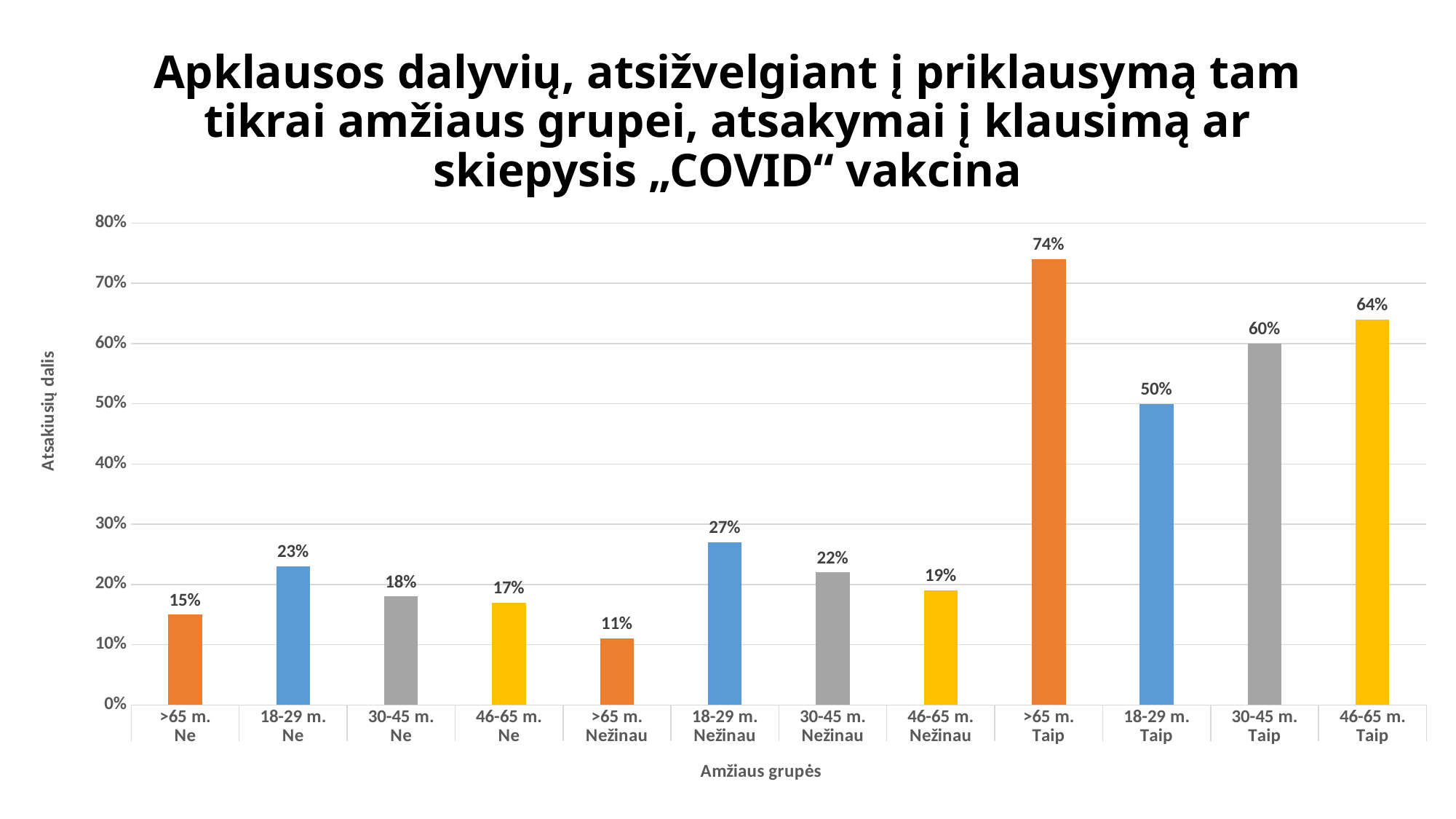
What is the label of the vertical axis? Atsakiusių dalis Which category has the highest value? >65 m. Taip What is the label of the horizontal axis? Amžiaus grupės What is the value for the "46-65 m. Ne" bar? 17% What is the value for the "18-29 m. Nežinau" bar? 27% How many bars are shown in the chart? 12 Which category has the lowest value? >65 m. Nežinau Which is larger: the value for "18-29 m. Ne" or the value for "30-45 m. Nežinau"? 18-29 m. Ne What kind of chart is shown on the slide? bar chart What is the difference between the "46-65 m. Taip" and "30-45 m. Taip" values? 4% Is the value for "18-29 m. Taip" greater or less than 40%? greater What is the value for the ">65 m. Taip" bar? 74%